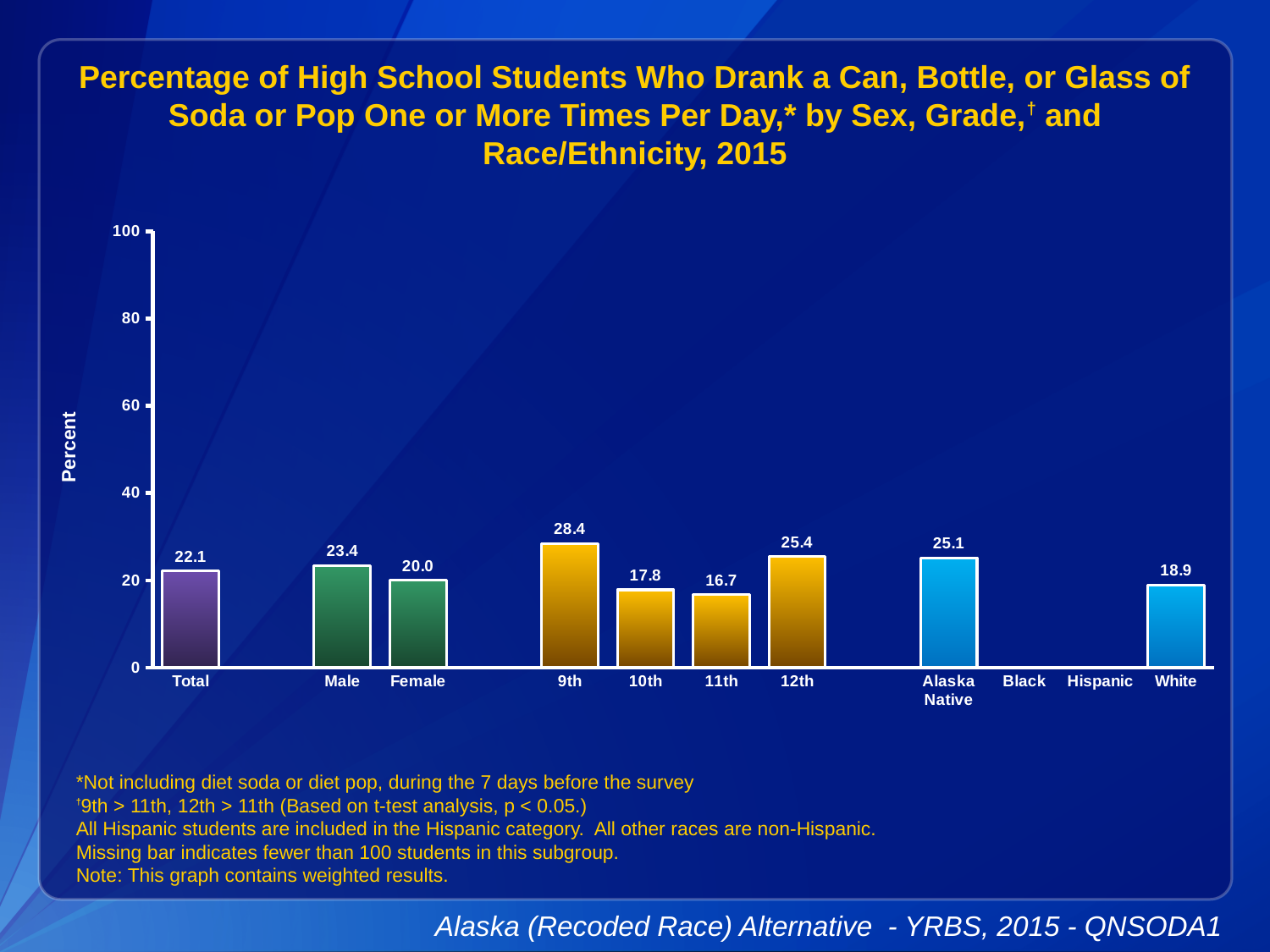
Is the value for White greater or less than 20? less How many categories on the x axis have no bar shown? 2 What is the value for Alaska Native? 25.1 What kind of chart is shown? bar chart What is the value for Total? 22.1 What is the label of the y axis? Percent What is the difference between the Male and Female values? 3.4 What is the value for 11th grade? 16.7 Which category has the highest value? 9th Which is larger, the value for 12th grade or the value for 10th grade? 12th What is the value for Male? 23.4 Which category with a bar has the lowest value? 11th